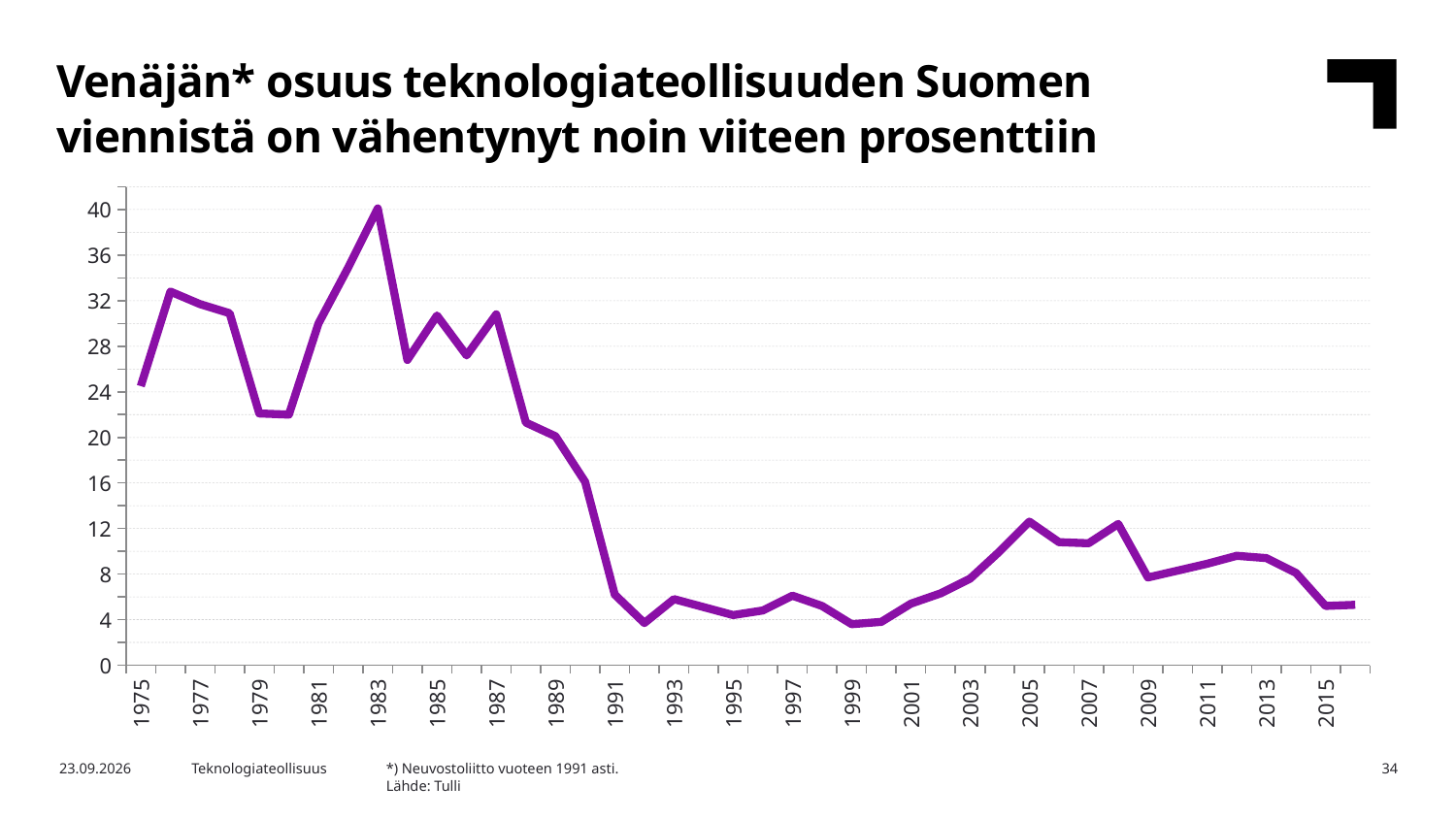
What source is cited for the chart data? Tulli Is the value for 1992 greater or less than 8? less Is the value for 2005 greater or less than 8? greater Which year has the larger value, 1983 or 1987? 1983 Is the value for 2015 greater or less than 8? less In which year does the line reach its highest value? 1983 What is the title of the chart on the slide? Venäjän* osuus teknologiateollisuuden Suomen viennistä on vähentynyt noin viiteen prosenttiin Which year has the larger value, 1977 or 2005? 1977 What kind of chart is shown on the slide? line chart Overall, does the line rise or fall from 1975 to the end of the series? fall